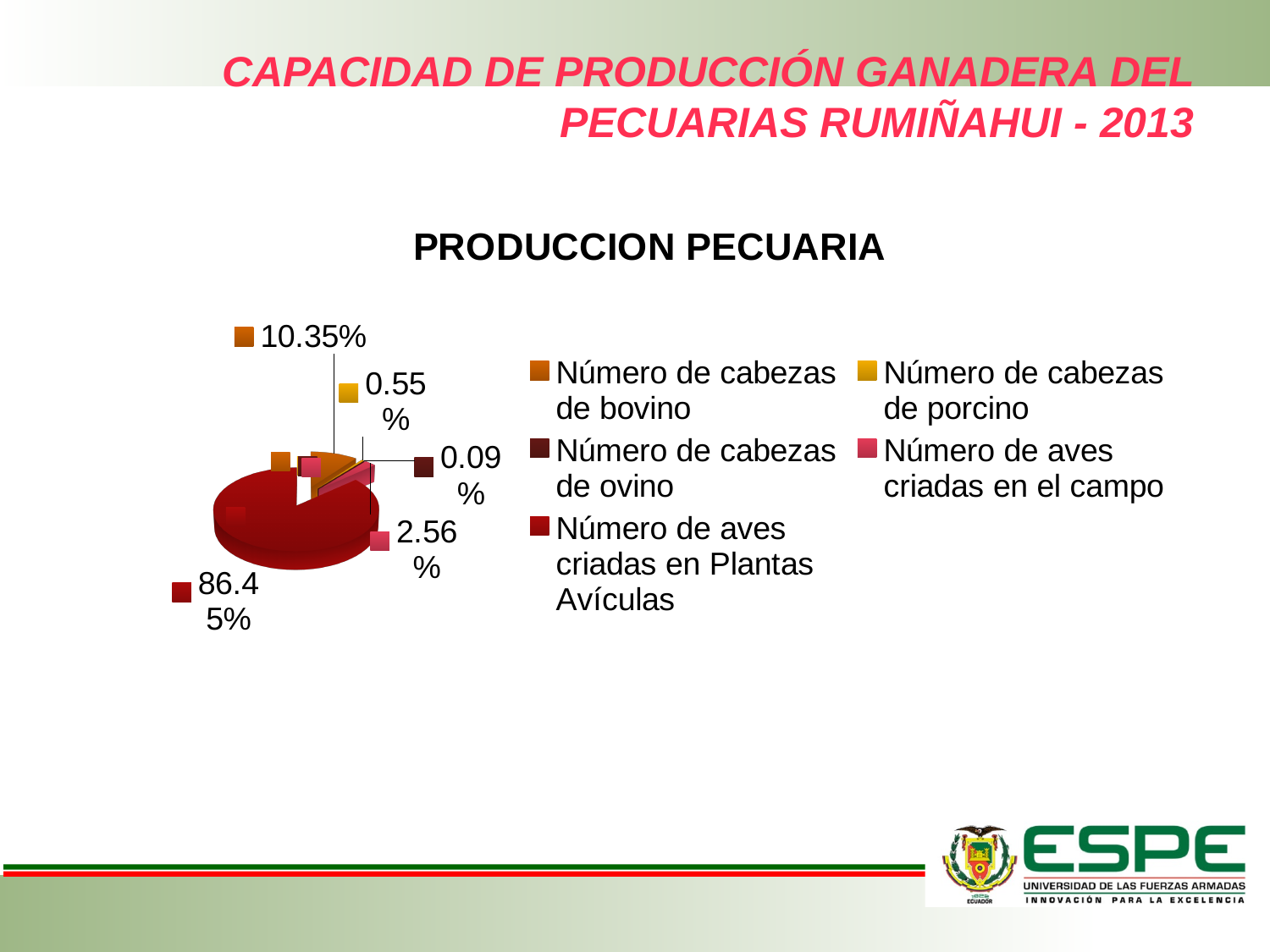
Which category has the largest share of the pie? Número de aves criadas en Plantas Avículas What percentage is shown for Número de cabezas de bovino? 10.35% What type of chart is shown on the slide? Pie chart Which is larger, the share for Número de cabezas de bovino or for Número de aves criadas en el campo? Número de cabezas de bovino What percentage is shown for Número de aves criadas en el campo? 2.56% What percentage is shown for Número de cabezas de ovino? 0.09% What percentage is shown for Número de cabezas de porcino? 0.55% What percentage is shown for Número de aves criadas en Plantas Avículas? 86.45% Which category has the smallest share of the pie? Número de cabezas de ovino What is the title of the chart? PRODUCCION PECUARIA What is the difference in percentage points between Número de cabezas de bovino and Número de aves criadas en el campo? 7.79 How many entries does the chart legend list? 5